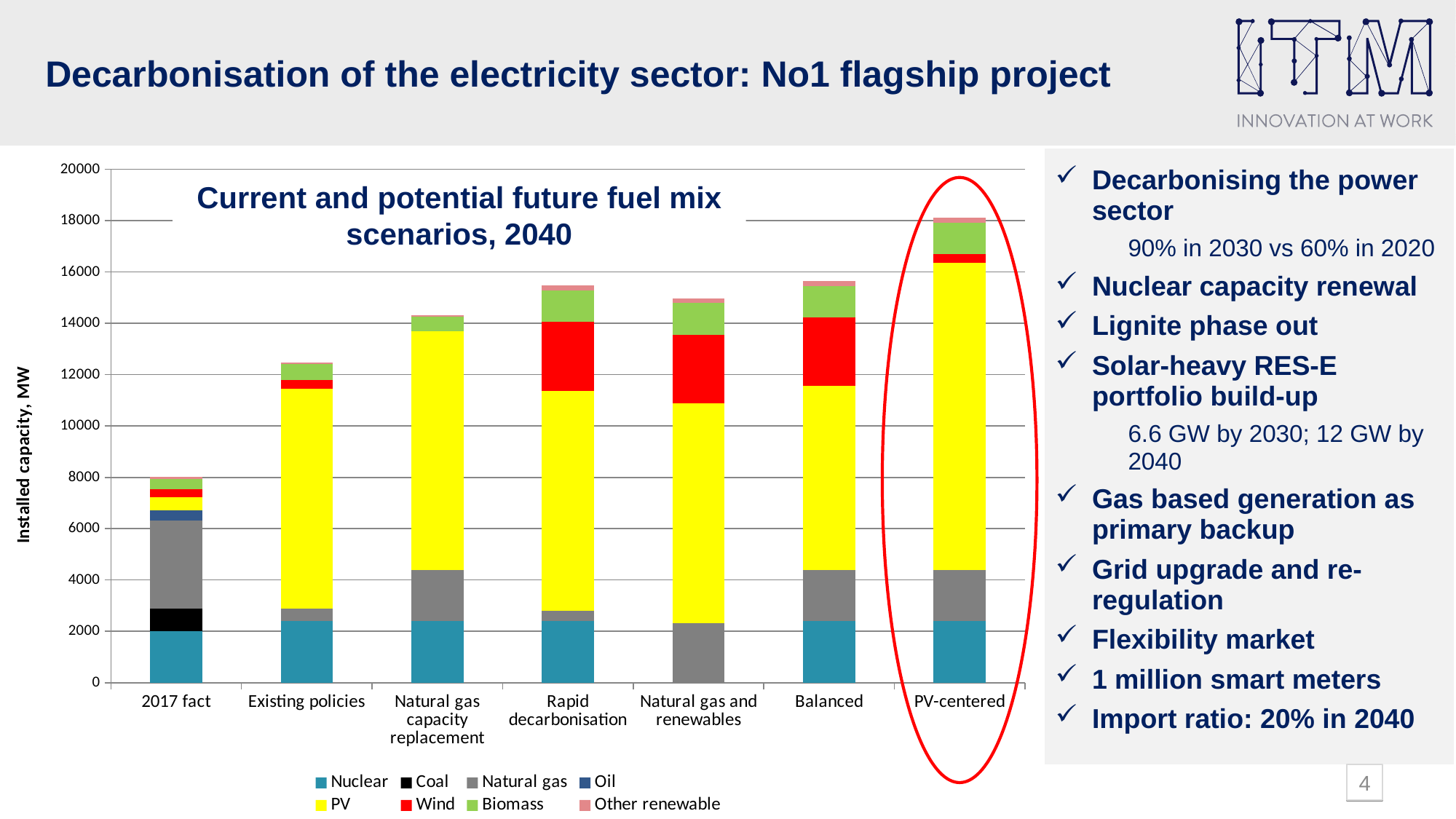
Is the total installed capacity for Balanced greater or less than 14000 MW? greater Is the total installed capacity for Natural gas and renewables greater or less than 16000 MW? less In which category does the Coal series appear? 2017 fact How many series does the chart legend list? 8 How many scenario categories are shown on the x axis of the chart? 7 Which has the larger total installed capacity, Existing policies or Balanced? Balanced Which category on the chart is circled in red? PV-centered Is the total installed capacity for Existing policies greater or less than 12000 MW? greater Which category has the lowest total installed capacity? 2017 fact What type of chart is shown on the slide? Stacked bar chart What is the title of the chart? Current and potential future fuel mix scenarios, 2040 Which category has the highest total installed capacity? PV-centered